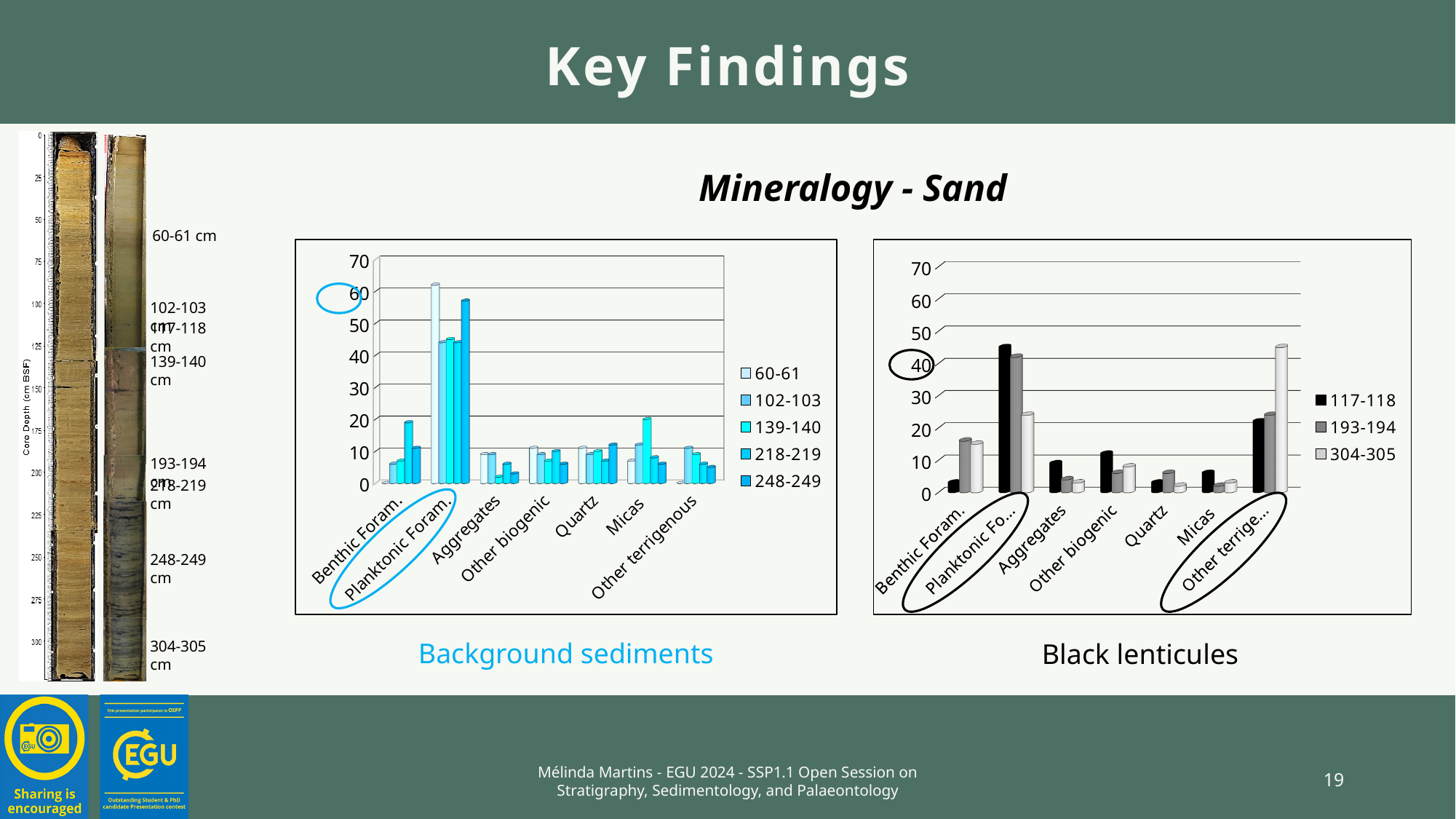
In the Background sediments chart, which is larger for Benthic Foram.: the 139-140 series or the 60-61 series? 139-140 How many series does the legend of the Black lenticules chart list? 3 How many categories are shown on the x axis of the Background sediments chart? 7 In the Background sediments chart, is the value for Planktonic Foram. in the 60-61 series greater or less than 50? greater In the Black lenticules chart, is the value for Planktonic Foram. in the 117-118 series greater or less than 40? greater In the Background sediments chart, is the value for Micas in the 139-140 series greater or less than 10? greater In the Background sediments chart, which category has the tallest bar overall? Planktonic Foram. How many series does the legend of the Background sediments chart list? 5 In the Black lenticules chart, which is larger for Planktonic Foram.: the 117-118 series or the 304-305 series? 117-118 What kind of chart is the Background sediments chart? bar chart What is the title shown above the two charts? Mineralogy - Sand